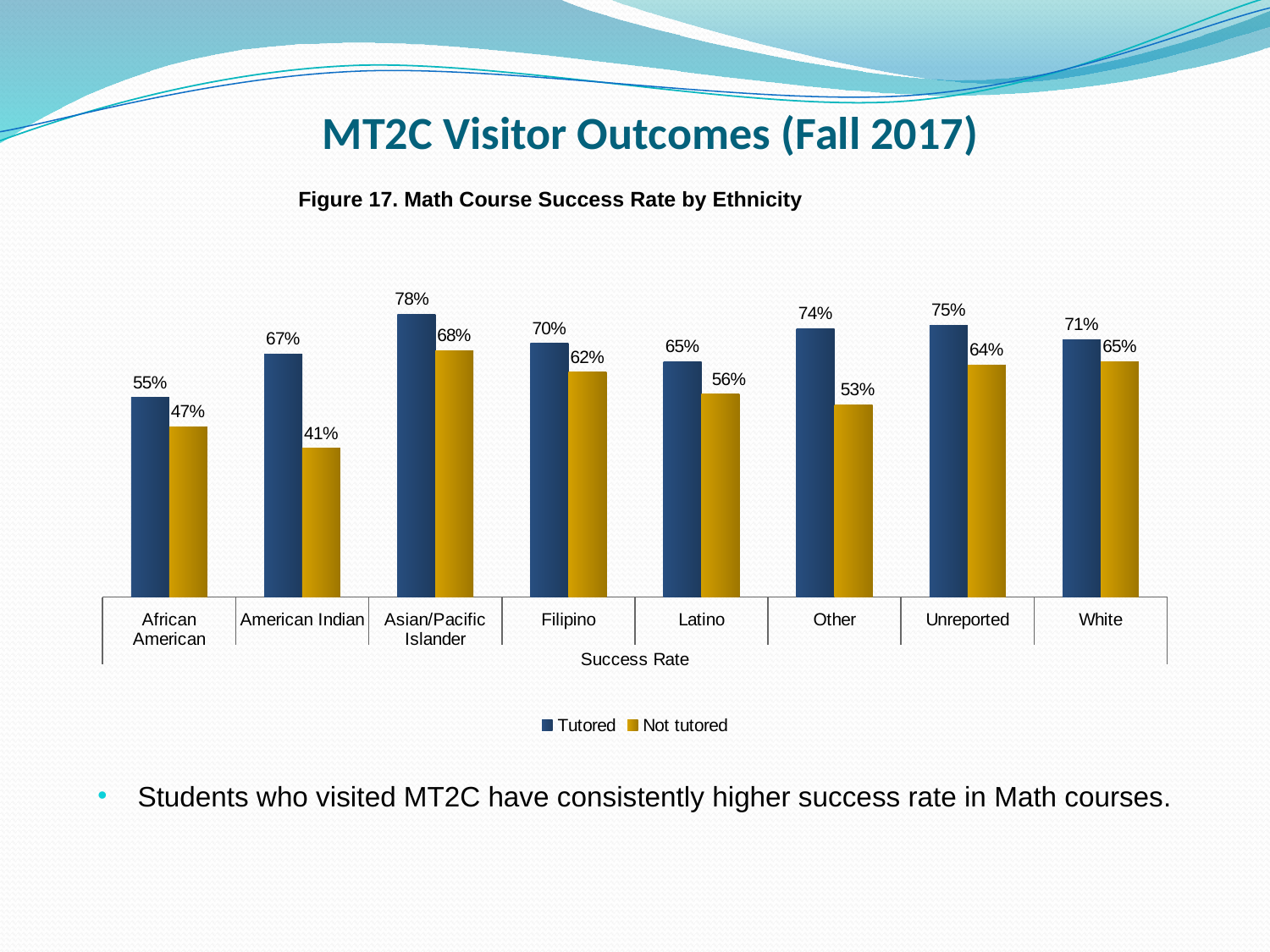
What is the Tutored success rate for Asian/Pacific Islander students? 78% What is the title of the figure shown on the slide? Figure 17. Math Course Success Rate by Ethnicity What is the Not tutored success rate for American Indian students? 41% What is the difference between the Tutored and Not tutored success rates for Other students? 21% Which ethnicity has the lowest Not tutored success rate? American Indian How many ethnicity categories are shown on the x axis? 8 What kind of chart is shown on the slide? Bar chart What is the difference between the Tutored and Not tutored success rates for Asian/Pacific Islander students? 10% Which is larger: the Tutored success rate for Filipino students or the Tutored success rate for White students? Filipino Which ethnicity has the highest Tutored success rate? Asian/Pacific Islander How many series does the legend list? 2 What is the Not tutored success rate for Latino students? 56%